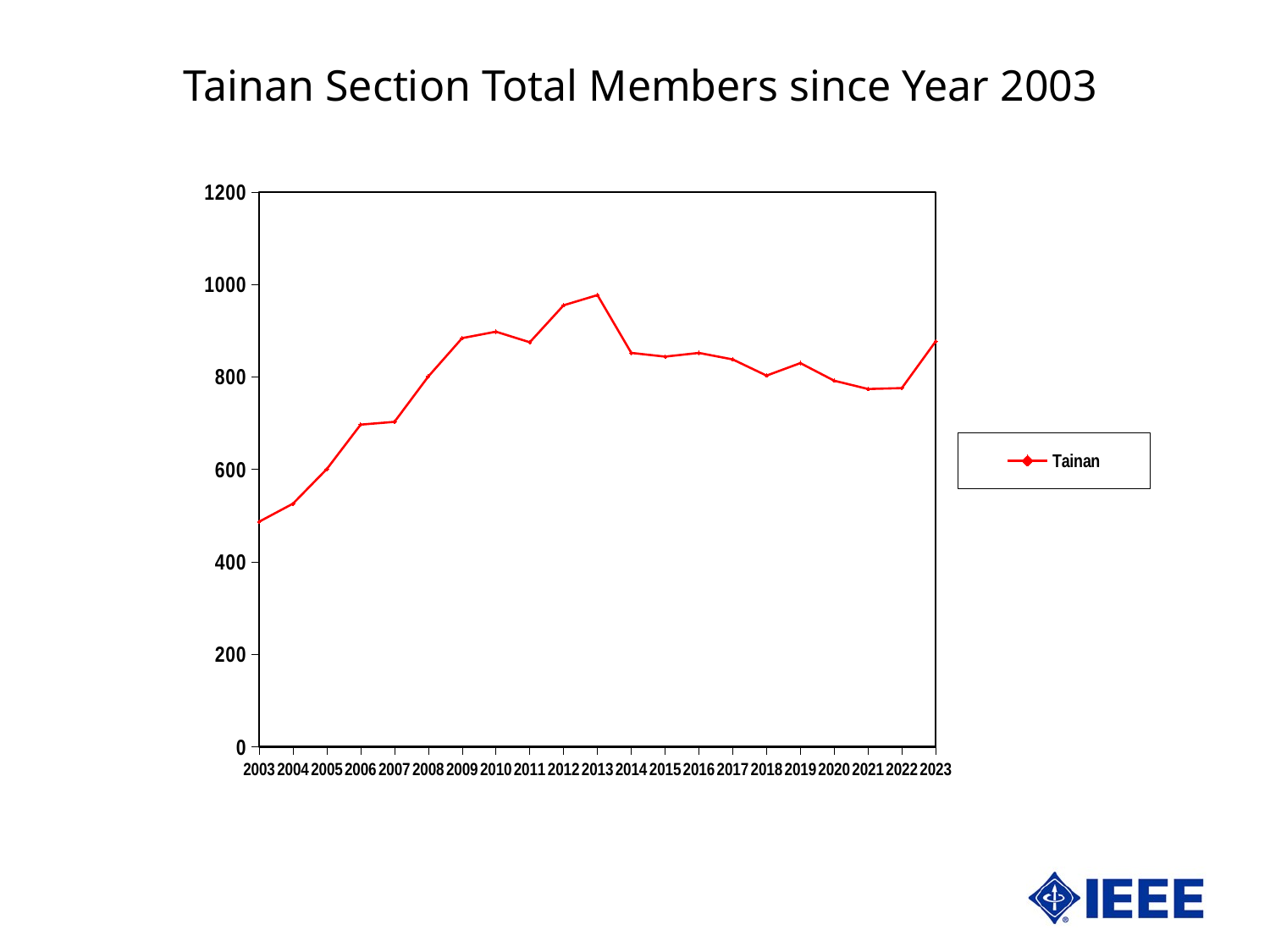
How many years are plotted along the x axis? 21 Which year has more members, 2005 or 2010? 2010 What kind of chart is shown on the slide? line chart Do the values rise or fall from 2003 to 2013? rise Is the value for 2003 greater or less than 600? less Is the value for 2009 greater or less than 800? greater What is the title of the chart? Tainan Section Total Members since Year 2003 How many series does the legend list? 1 Is the value for 2013 greater or less than 800? greater What is the name of the series shown in the legend? Tainan In which year is the number of Tainan members lowest? 2003 In which year is the number of Tainan members highest? 2013